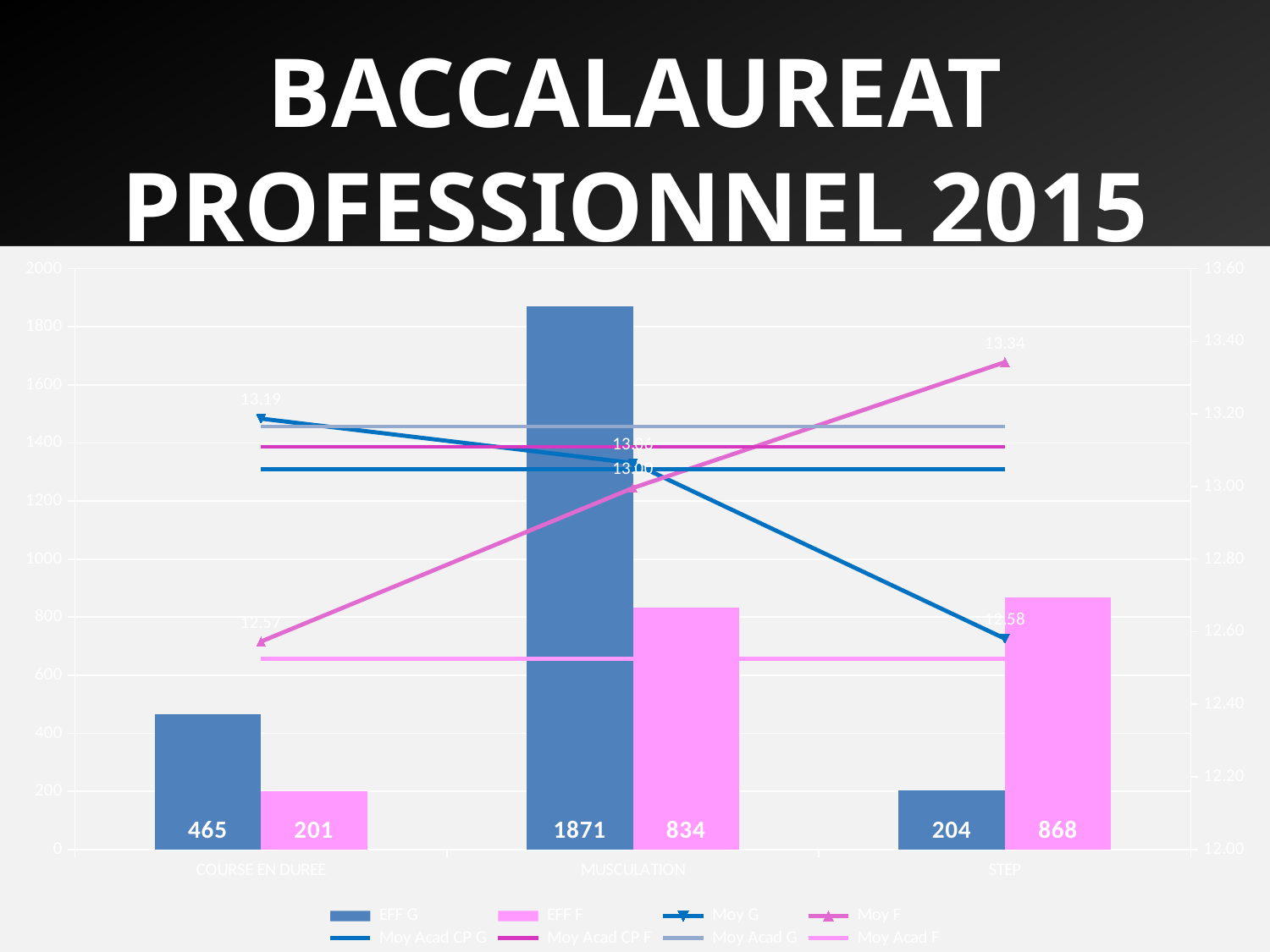
How many categories are shown on the x axis? 3 How many series does the legend list? 8 Which category has the highest EFF G value? MUSCULATION Does the Moy G line rise or fall from COURSE EN DUREE to STEP? fall What is the EFF G value for MUSCULATION? 1871 What is the title of the slide containing the chart? BACCALAUREAT PROFESSIONNEL 2015 What is the EFF F value for STEP? 868 Which category has the lowest EFF F value? COURSE EN DUREE What is the difference between EFF G and EFF F for COURSE EN DUREE? 264 For STEP, which is larger, EFF G or EFF F? EFF F What is the Moy G value for STEP? 12.58 What is the Moy F value for COURSE EN DUREE? 12.57